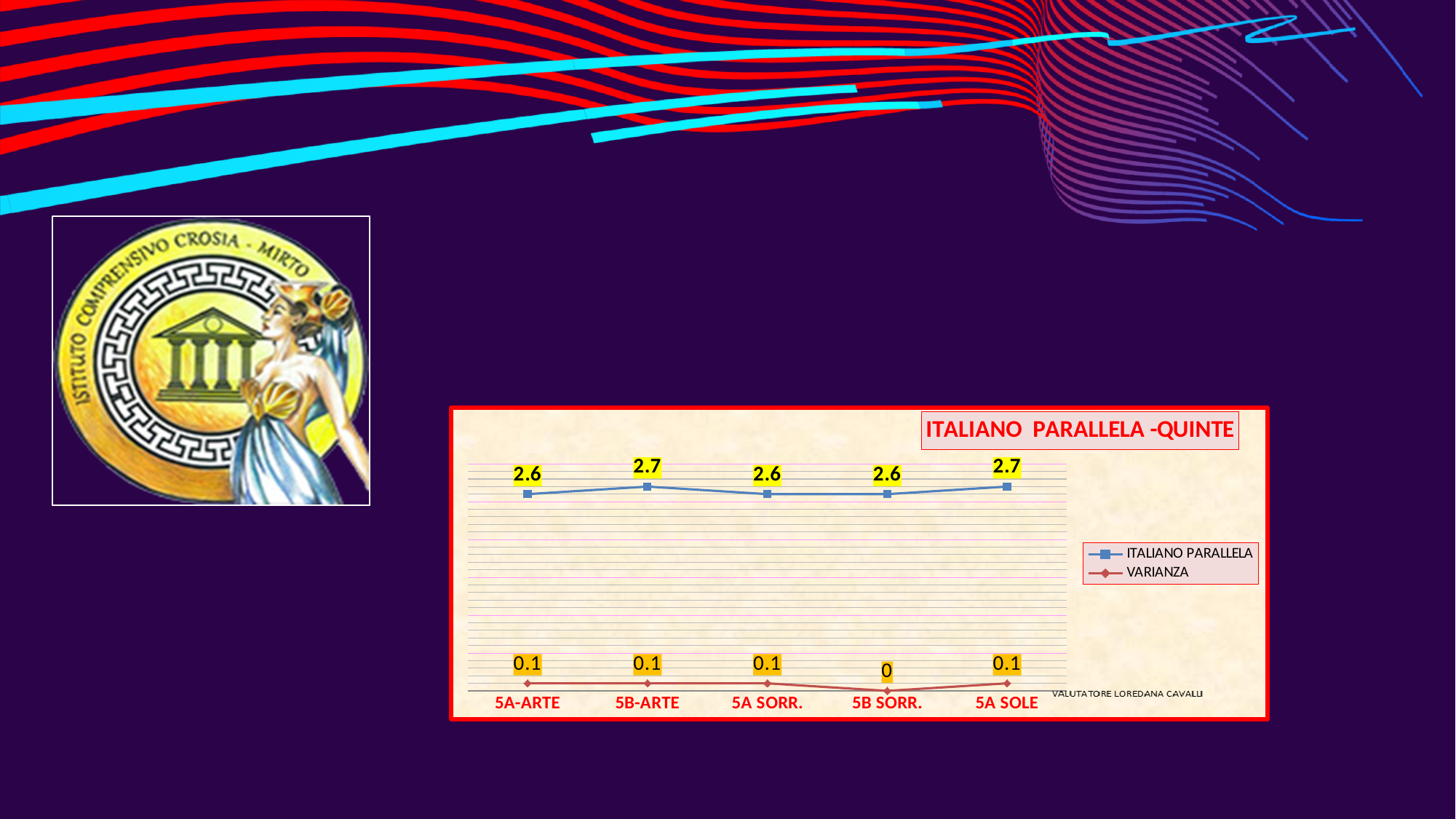
What is the VARIANZA value for 5A SOLE? 0.1 What is the title of the chart? ITALIANO PARALLELA -QUINTE What is the ITALIANO PARALLELA value for 5B-ARTE? 2.7 Which is larger, the ITALIANO PARALLELA value for 5A SOLE or for 5B SORR.? 5A SOLE How many categories are shown on the x axis? 5 Which category has the lowest VARIANZA value? 5B SORR. How many series does the legend list? 2 What is the difference between the ITALIANO PARALLELA values for 5B-ARTE and 5A-ARTE? 0.1 What is the VARIANZA value for 5B SORR.? 0 What is the ITALIANO PARALLELA value for 5A SORR.? 2.6 What colour is the VARIANZA line? red What kind of chart is shown? line chart